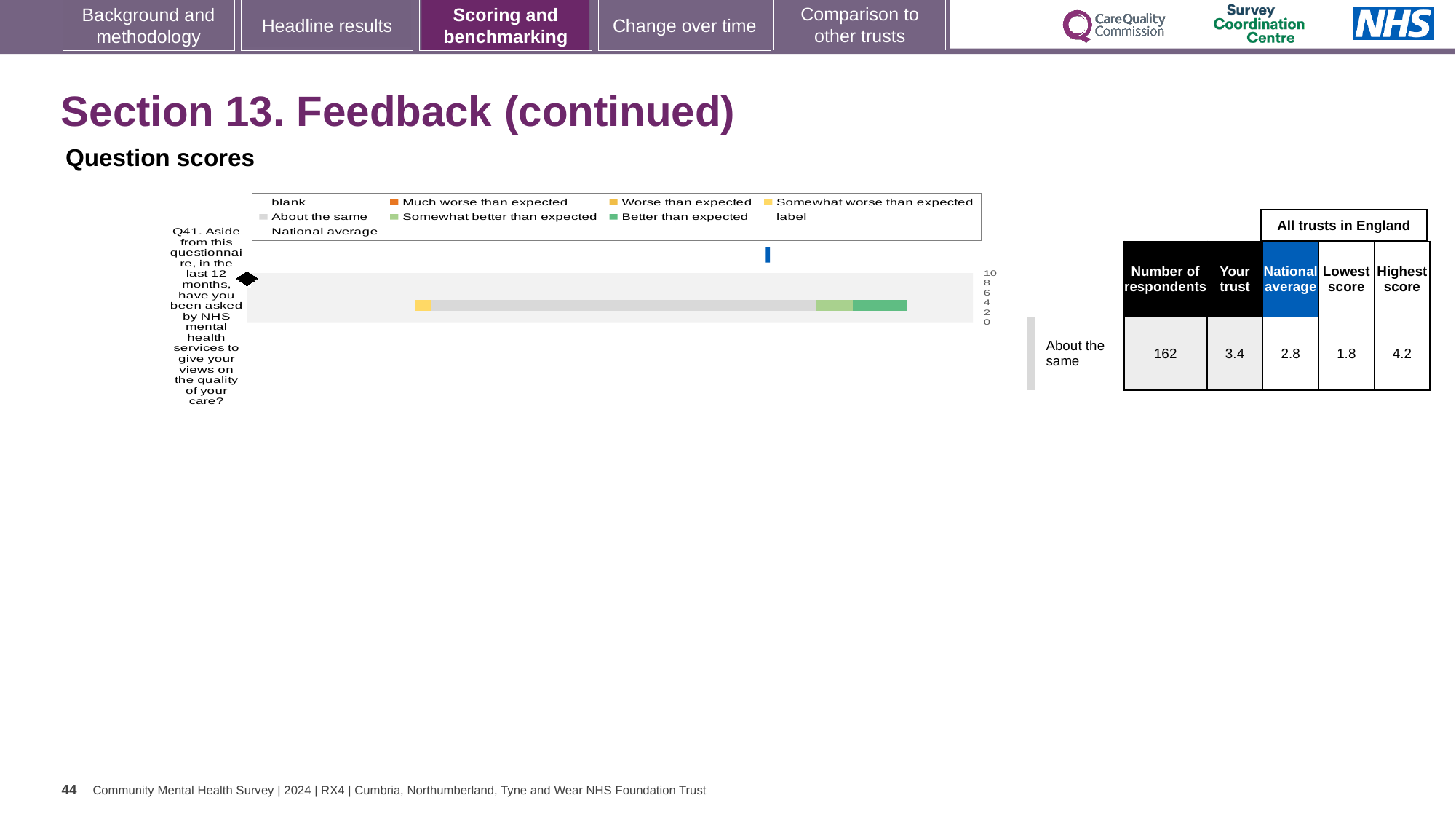
What is the lowest score among all trusts in England for Q41? 1.8 What benchmark category is given for Q41 next to the chart? About the same What is the difference between the highest score and the lowest score for Q41? 2.4 How many entries does the chart's legend list? 9 Which question number is plotted in the chart? Q41 Which is larger for Q41, the 'Your trust' score or the national average? Your trust How many respondents answered Q41? 162 What is the highest score among all trusts in England for Q41? 4.2 What is the national average score for Q41 shown in the table beside the chart? 2.8 What kind of chart is shown on the slide? bar chart How many questions are plotted as bars in the chart? 1 What is the 'Your trust' score for Q41 shown in the table beside the chart? 3.4